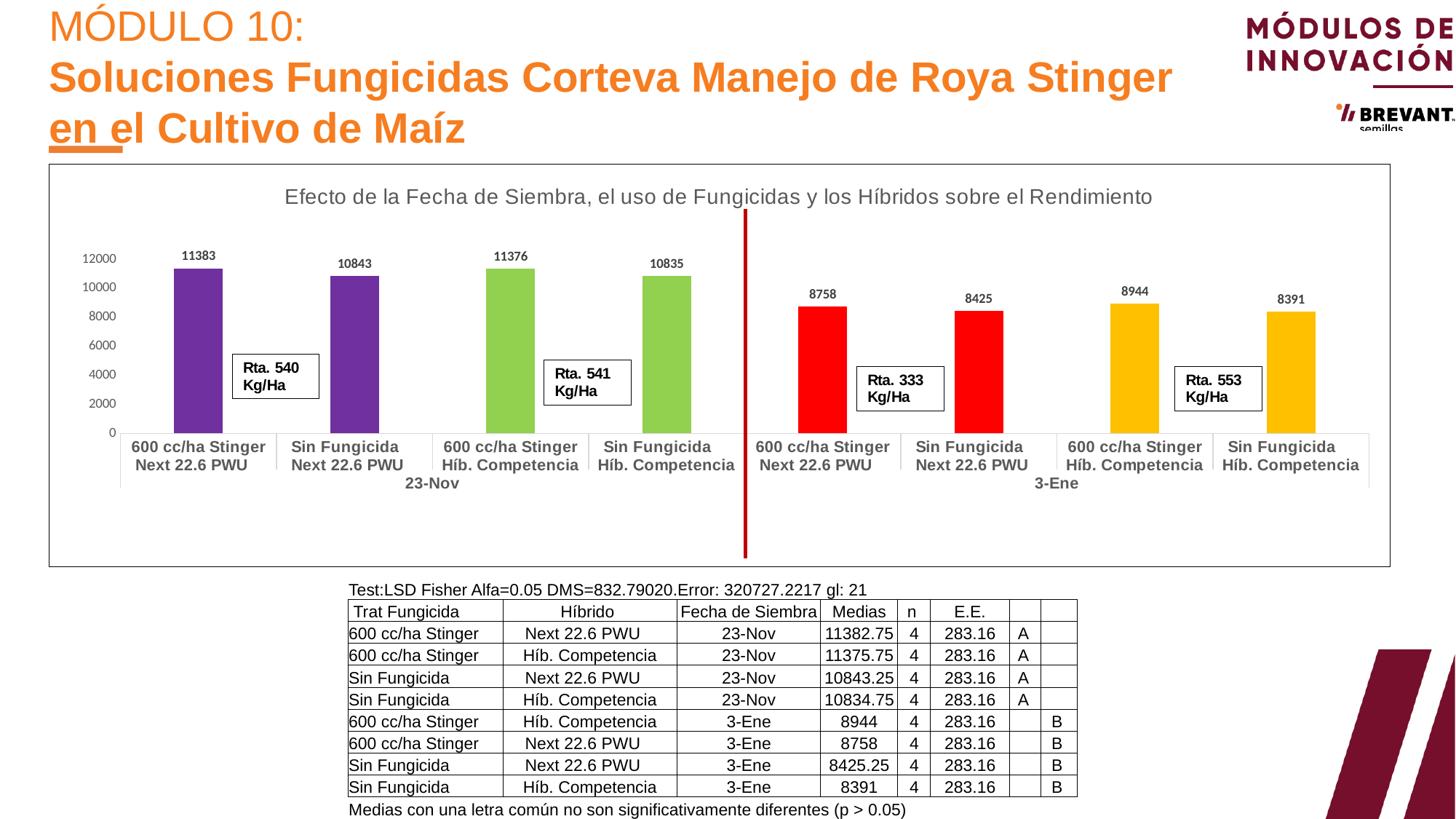
Which bar has the highest value in the chart? 600 cc/ha Stinger Next 22.6 PWU (23-Nov) What is the title of the chart? Efecto de la Fecha de Siembra, el uso de Fungicidas y los Híbridos sobre el Rendimiento What is the difference between 600 cc/ha Stinger Next 22.6 PWU and Sin Fungicida Next 22.6 PWU at 23-Nov? 540 What is the difference between 600 cc/ha Stinger Híb. Competencia and Sin Fungicida Híb. Competencia at 3-Ene? 553 Is the value for Sin Fungicida Next 22.6 PWU at 3-Ene greater or less than 10000? less Which is larger: Sin Fungicida Next 22.6 PWU at 23-Nov or 600 cc/ha Stinger Next 22.6 PWU at 3-Ene? Sin Fungicida Next 22.6 PWU at 23-Nov What is the value for 600 cc/ha Stinger Híb. Competencia at the 3-Ene sowing date? 8944 What is the value for 600 cc/ha Stinger Next 22.6 PWU at the 23-Nov sowing date? 11383 What kind of chart is shown on the slide? bar chart How many bars are plotted in the chart? 8 Which bar has the lowest value in the chart? Sin Fungicida Híb. Competencia (3-Ene) What is the value for Sin Fungicida Híb. Competencia at the 3-Ene sowing date? 8391